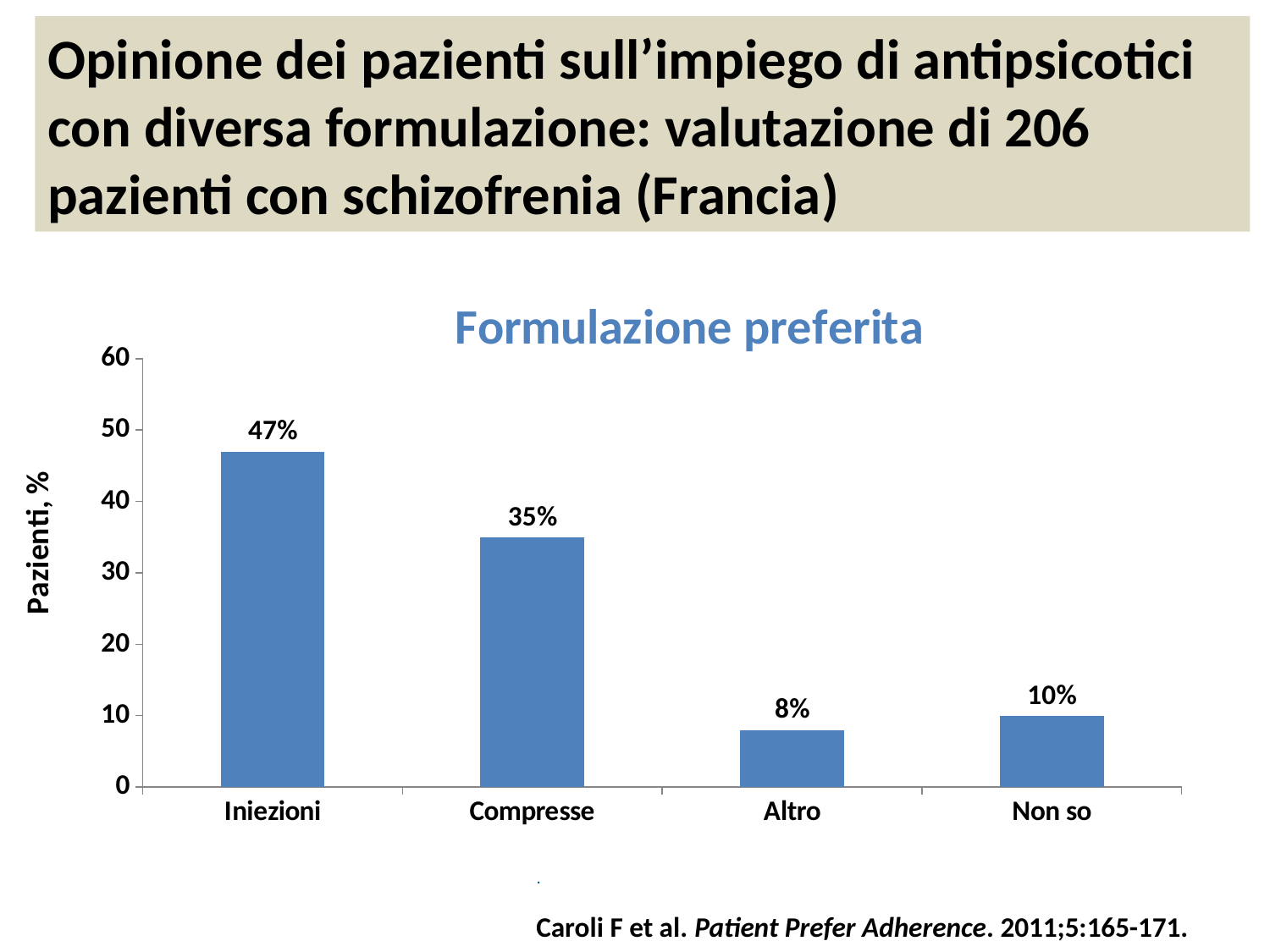
Which is larger, the value for Non so or the value for Altro? Non so Is the value for Compresse greater or less than 30? greater Which category has the lowest value? Altro Which category has the highest value? Iniezioni What kind of chart is shown? bar chart What is the value for Iniezioni? 47% What is the difference between the values for Iniezioni and Compresse? 12% What is the value for Altro? 8% What is the value for Non so? 10% What is the value for Compresse? 35% What is the title of the chart? Formulazione preferita How many categories are shown on the x axis? 4